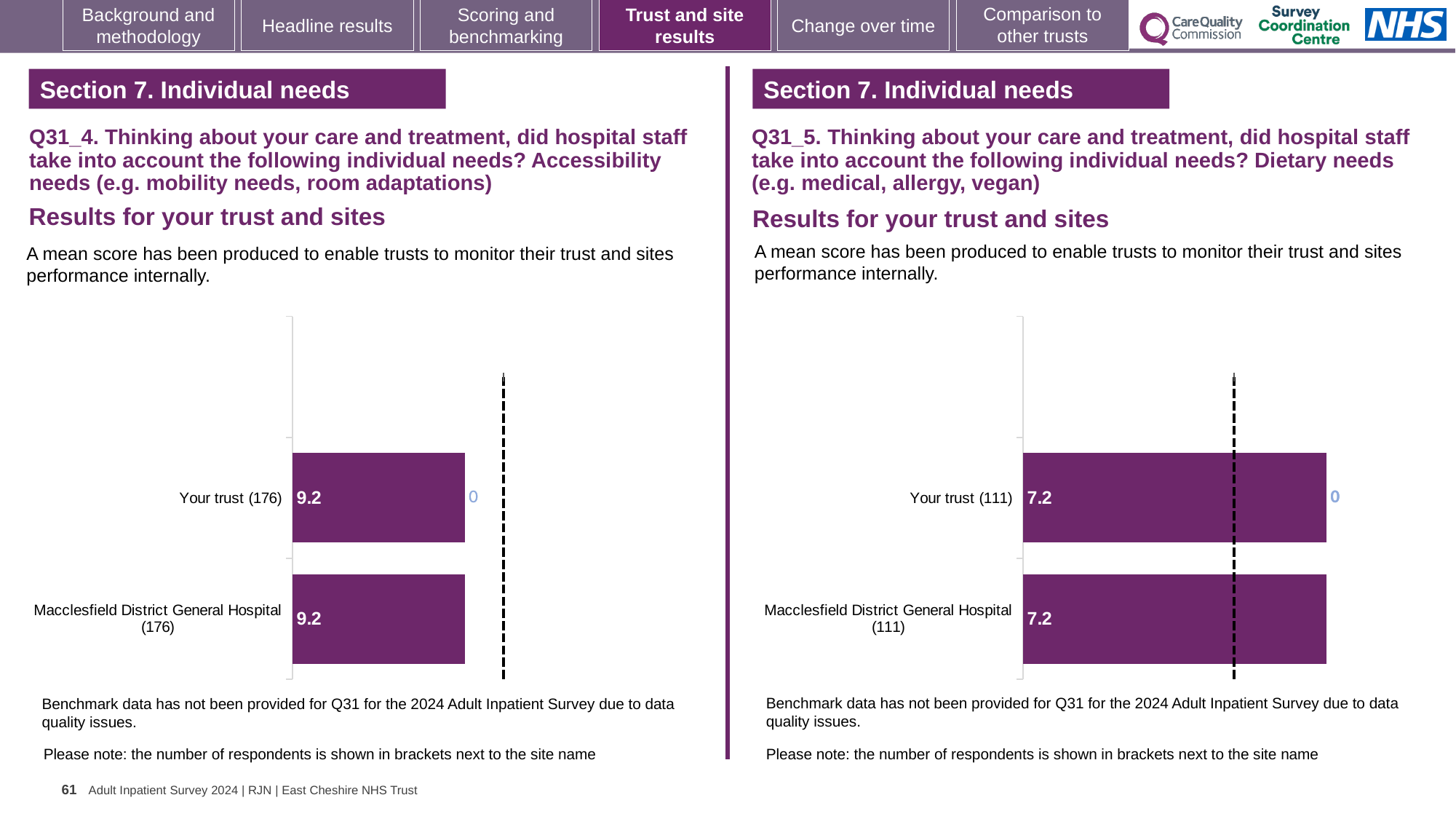
In the left chart (Q31_4), how many respondents are shown in brackets next to Your trust? 176 In the right chart (Q31_5, Dietary needs), what is the mean score for Your trust? 7.2 In the left chart (Q31_4, Accessibility needs), what is the mean score for Macclesfield District General Hospital? 9.2 What is the difference between the Your trust score in the left chart (Q31_4) and the Your trust score in the right chart (Q31_5)? 2.0 In the right chart (Q31_5, Dietary needs), what is the mean score for Macclesfield District General Hospital? 7.2 In the right chart (Q31_5), how many categories are shown? 2 In the left chart (Q31_4), how many bars are plotted? 2 In the left chart (Q31_4), is the score for Your trust higher than, lower than, or equal to the score for Macclesfield District General Hospital? Equal What kind of chart is used in the left chart (Q31_4)? Bar chart Which is larger: the Your trust score in the left chart (Q31_4) or the Your trust score in the right chart (Q31_5)? Left chart (Q31_4), 9.2 In the right chart (Q31_5), how many respondents are shown in brackets next to Macclesfield District General Hospital? 111 In the left chart (Q31_4, Accessibility needs), what is the mean score for Your trust? 9.2